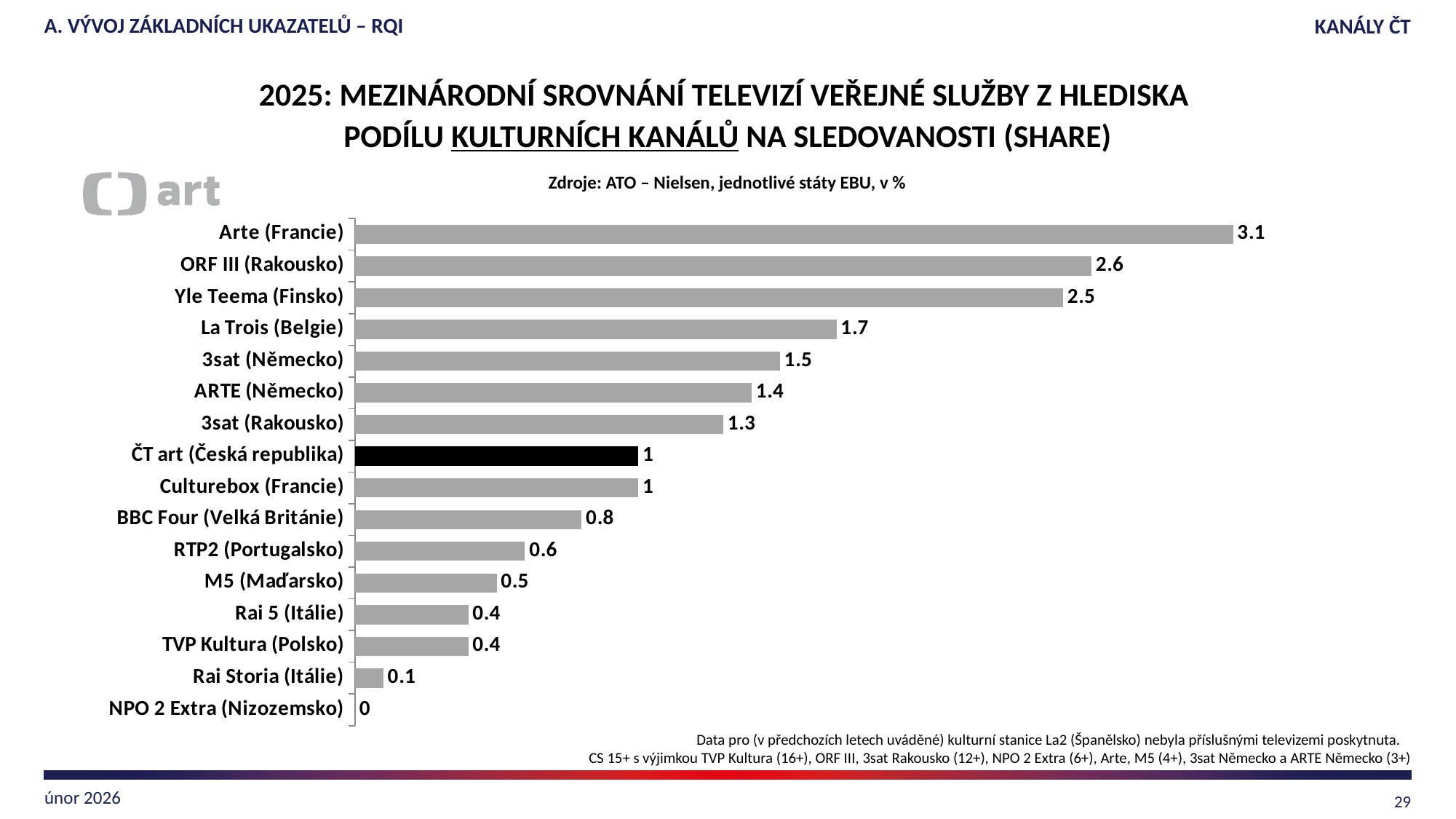
What is the value for ČT art (Česká republika)? 1 Which channel has the highest value? Arte (Francie) What kind of chart is shown on the slide? Bar chart What is the difference between the values for ČT art (Česká republika) and Rai Storia (Itálie)? 0.9 Which bar is coloured black instead of grey? ČT art (Česká republika) What is the difference between the values for Arte (Francie) and ORF III (Rakousko)? 0.5 How many channels are shown in the chart? 16 Which channel has the lowest value? NPO 2 Extra (Nizozemsko) Which is larger, the value for RTP2 (Portugalsko) or the value for M5 (Maďarsko)? RTP2 (Portugalsko) What is the value for Arte (Francie)? 3.1 What is the value for BBC Four (Velká Británie)? 0.8 Which is larger, the value for La Trois (Belgie) or the value for 3sat (Německo)? La Trois (Belgie)